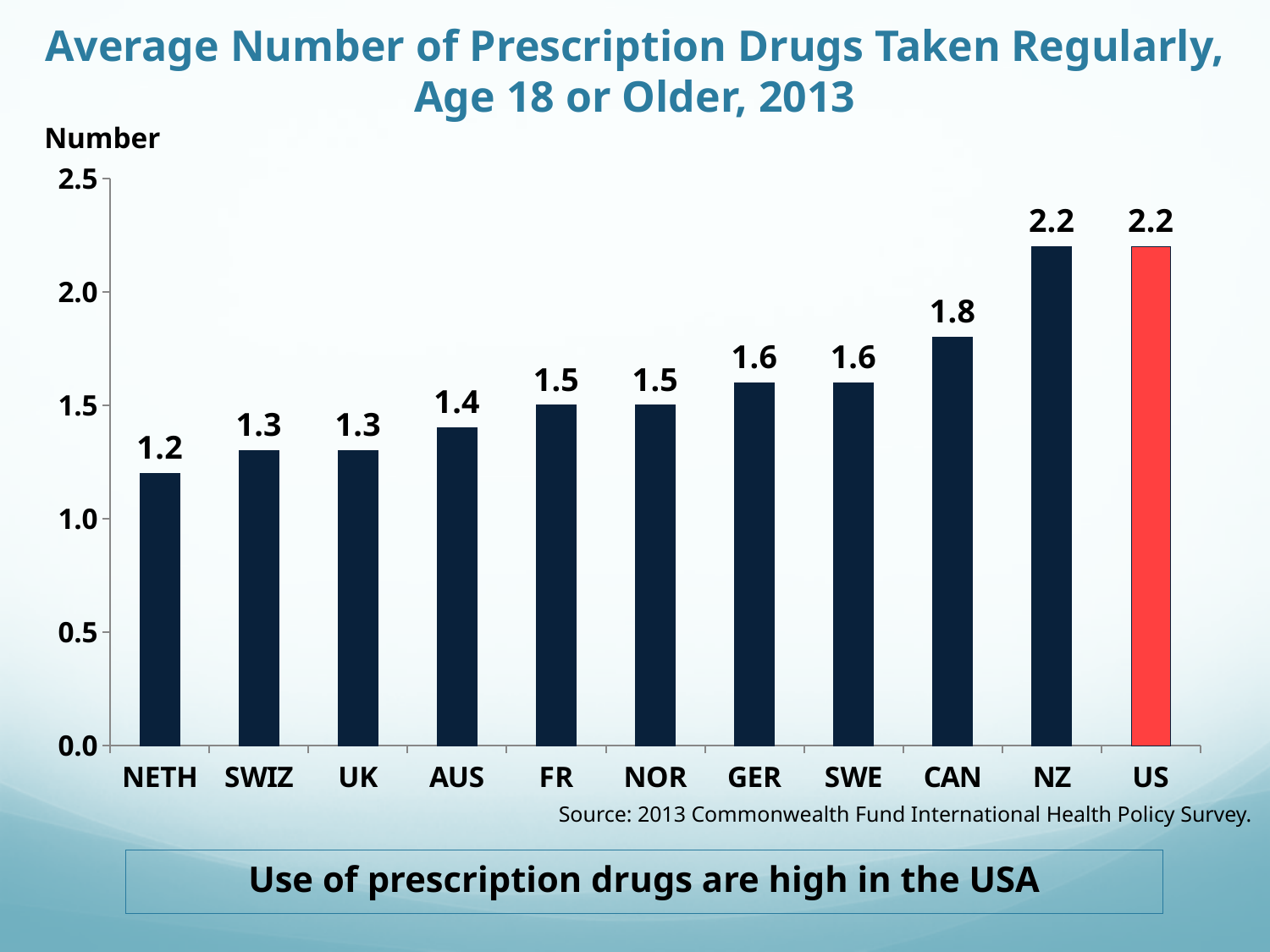
Is the value for NZ greater or less than 2.0? greater Which country has the lowest value on the chart? NETH What is the difference between the values for CAN and GER? 0.2 What is the value shown for AUS? 1.4 What is the value shown for NETH? 1.2 What is the difference between the values for US and NETH? 1.0 Do the values generally rise or fall from left to right across the countries? rise What kind of chart is shown on the slide? bar chart Which is larger, the value for SWE or the value for UK? SWE What is the average number of prescription drugs taken regularly for CAN? 1.8 Which country's bar is coloured red? US How many countries are shown on the chart? 11